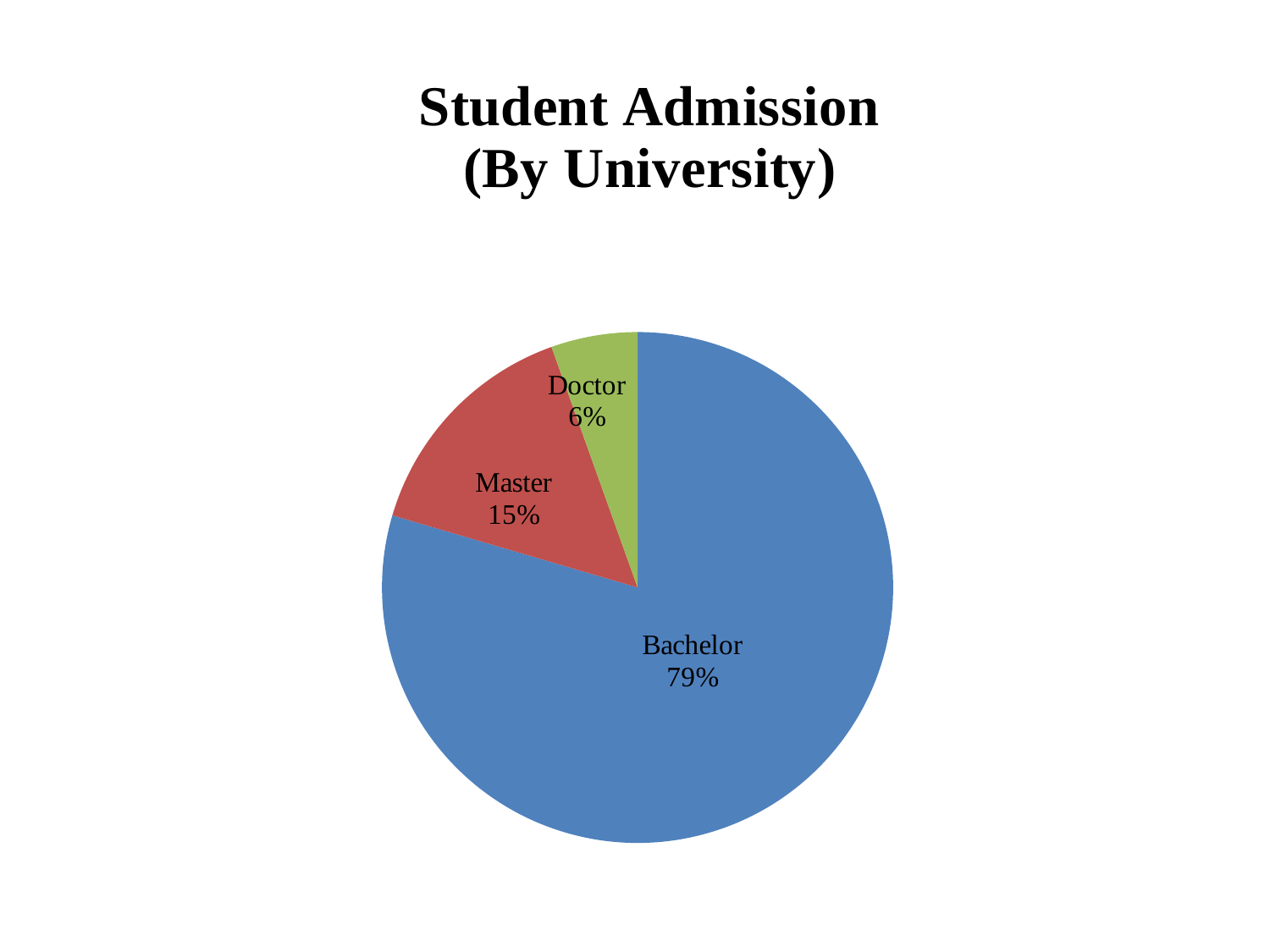
What kind of chart is shown on the slide? pie chart What share of student admissions is Bachelor? 79% What is the title of the chart? Student Admission (By University) Which is larger, the Master share or the Doctor share? Master Which category has the largest share of the pie? Bachelor What colour is the Bachelor slice? blue What share of student admissions is Master? 15% What is the difference in percentage points between the Bachelor and Master shares? 64 What is the difference in percentage points between the Master and Doctor shares? 9 Which category has the smallest share of the pie? Doctor What share of student admissions is Doctor? 6% How many slices does the pie chart have? 3